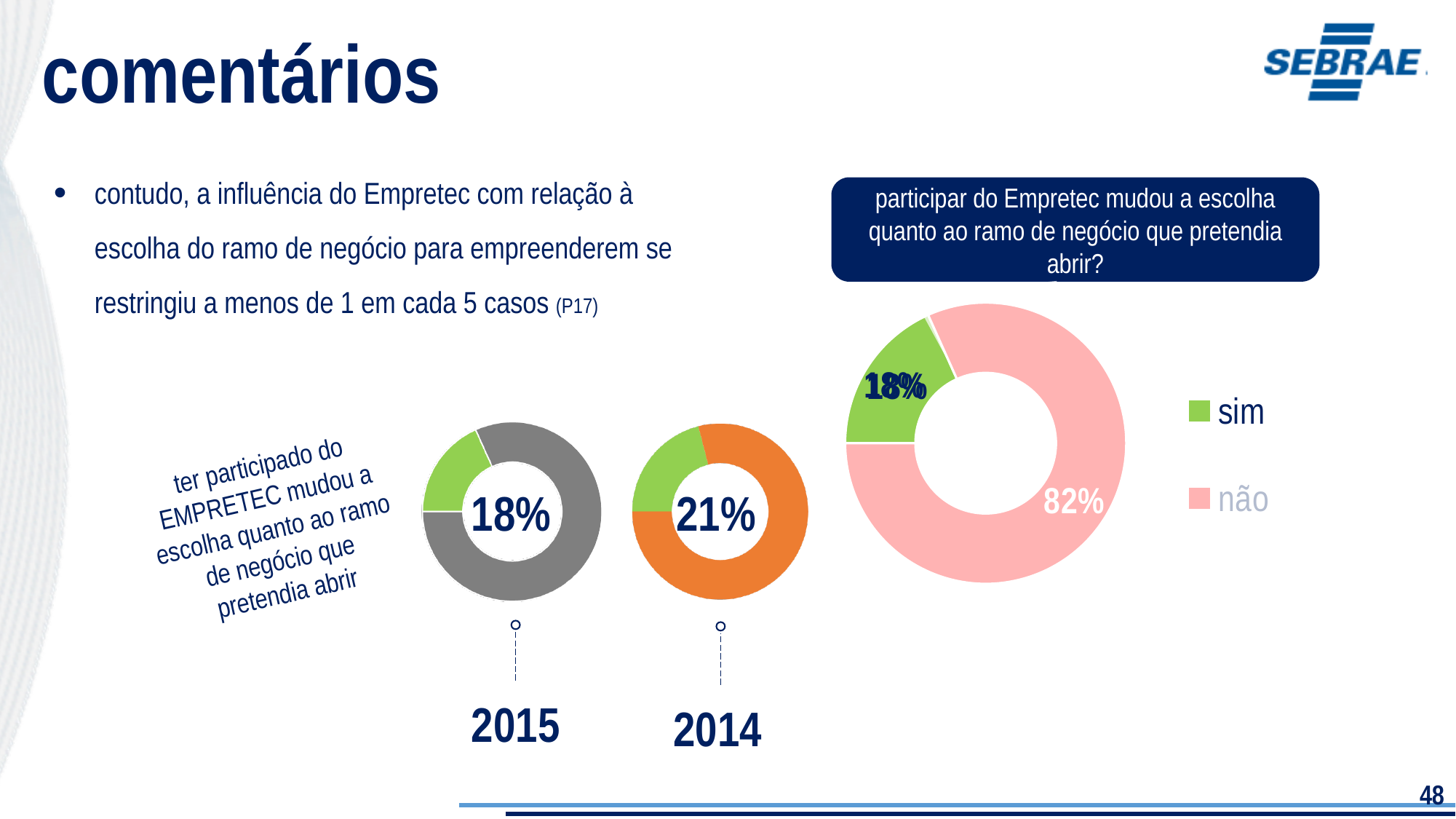
In the large chart on the right, what is the difference between the "não" share and the "sim" share? 64 percentage points How many small donut charts with year labels are shown on the slide? 2 In the large chart on the right, what share is labelled "não"? 82% In the small donut chart labelled 2015, what percentage is shown in the centre? 18% In the large chart on the right titled "participar do Empretec mudou a escolha quanto ao ramo de negócio que pretendia abrir?", what share is labelled "sim"? 18% In the small donut chart labelled 2014, what percentage is shown in the centre? 21% What is the difference between the percentage shown for 2014 and the percentage shown for 2015 in the small donut charts? 3 percentage points In the large chart on the right, which slice is larger, "sim" or "não"? não Comparing the small donut charts for 2015 and 2014, which year shows the higher percentage? 2014 How many entries does the legend of the large chart on the right list? 2 In the large chart on the right, what colour is the "sim" slice? Green What kind of chart is the large chart on the right? Donut (pie) chart